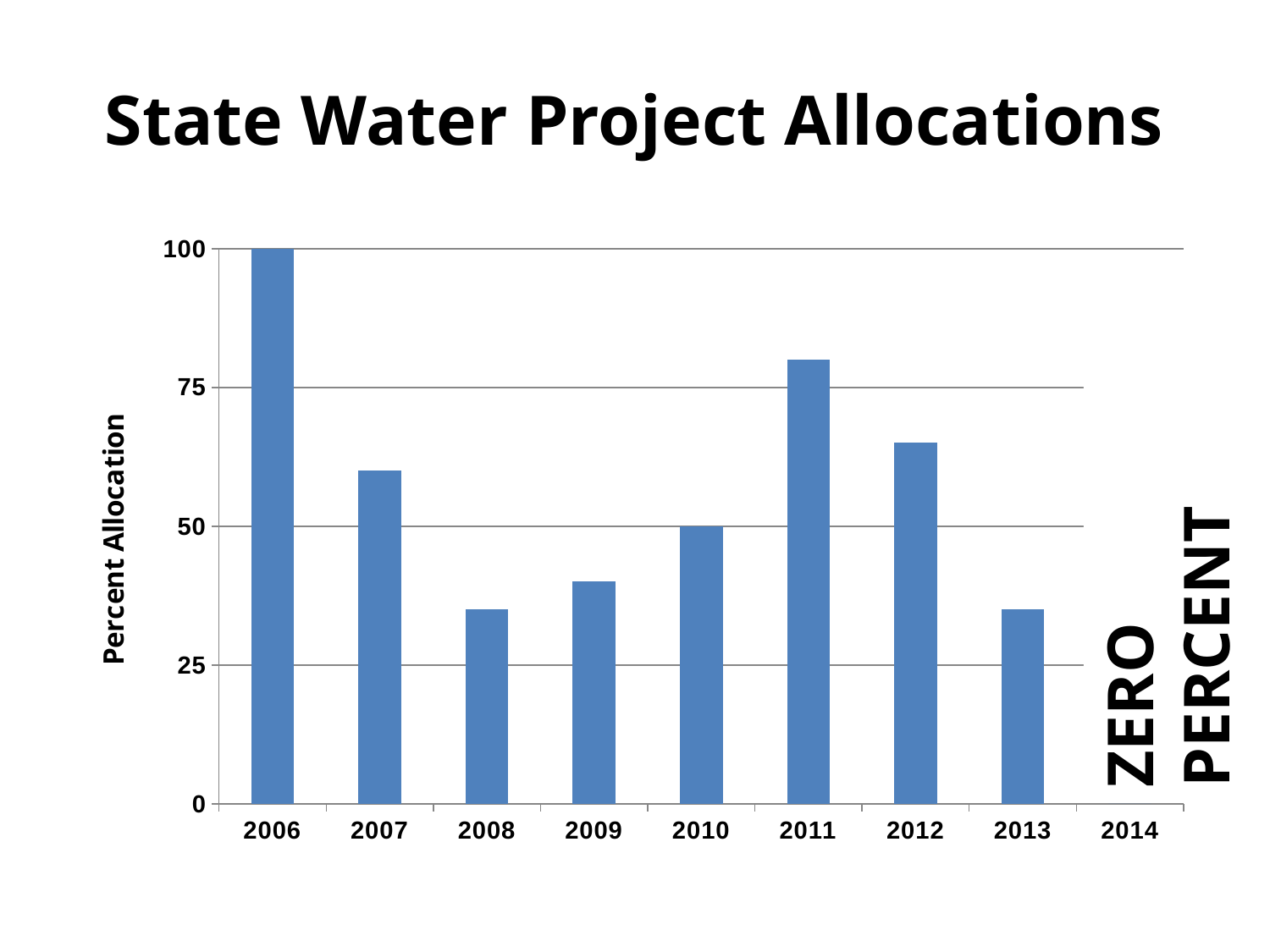
What is the percent allocation for 2010? 50 How many years are shown on the x axis? 9 Which year has the lowest percent allocation? 2014 Is the value for 2007 greater or less than 50? greater Which year has the larger percent allocation, 2011 or 2012? 2011 Which year has the highest percent allocation? 2006 Is the value for 2008 greater or less than 50? less What is the percent allocation for 2006? 100 What kind of chart is shown on the slide? bar chart What is the difference between the percent allocation in 2006 and in 2010? 50 Is the value for 2011 greater or less than 75? greater What is the percent allocation for 2014? 0 (zero percent)